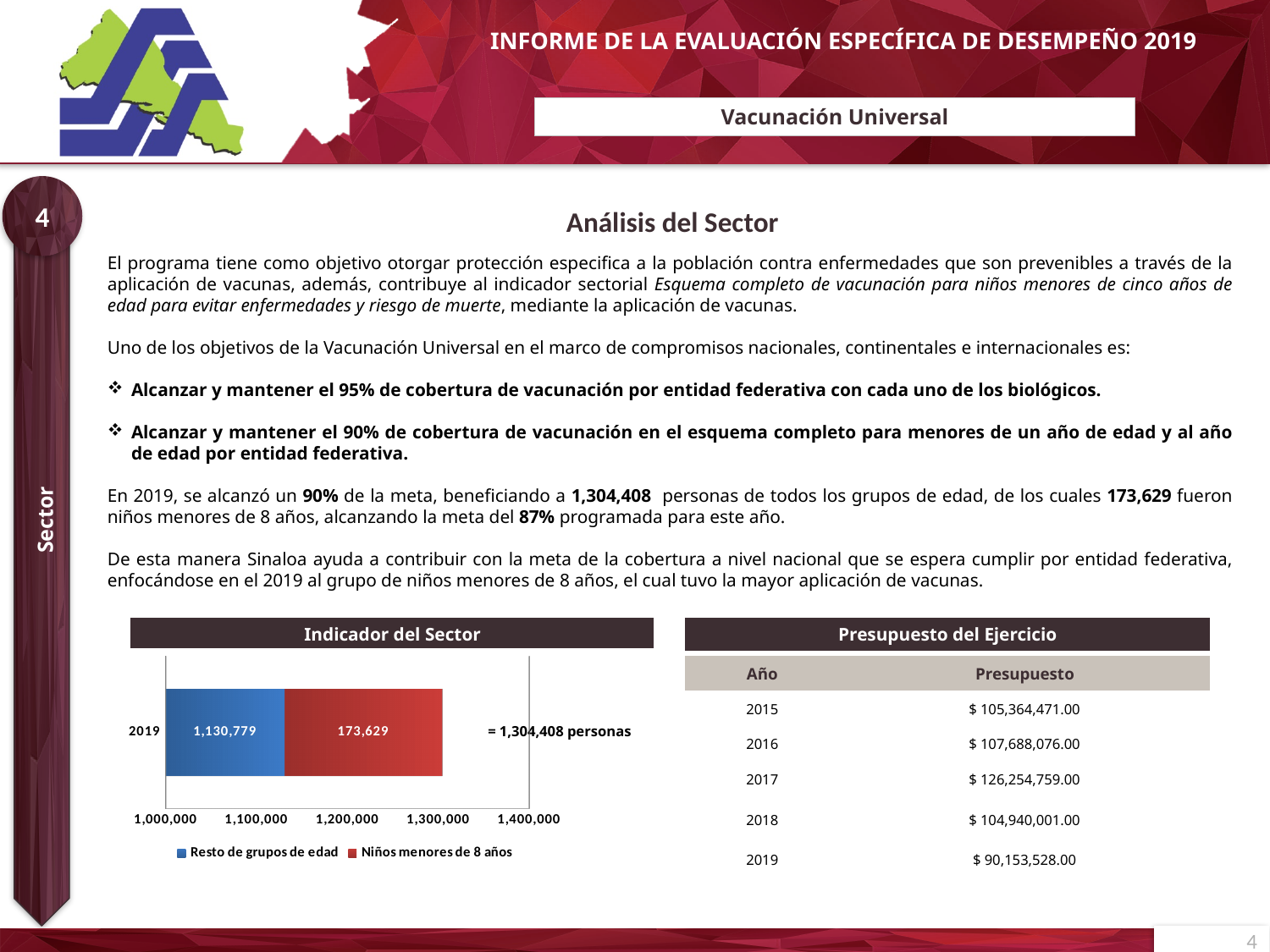
In the 'Indicador del Sector' chart, what is the value for 'Niños menores de 8 años' in 2019? 173,629 In the 'Indicador del Sector' chart, which series has the larger value: 'Resto de grupos de edad' or 'Niños menores de 8 años'? Resto de grupos de edad How many categories (years) are plotted in the 'Indicador del Sector' chart? 1 In the 'Indicador del Sector' chart, what colour represents 'Resto de grupos de edad'? Blue In the 'Indicador del Sector' chart, which series has the smallest value? Niños menores de 8 años In the 'Indicador del Sector' chart, what colour represents 'Niños menores de 8 años'? Red What kind of chart is the 'Indicador del Sector' chart? Stacked bar chart How many series does the legend of the 'Indicador del Sector' chart list? 2 In the 'Indicador del Sector' chart, what is the difference between the 'Resto de grupos de edad' value and the 'Niños menores de 8 años' value? 957,150 In the 'Indicador del Sector' chart, what is the value for 'Resto de grupos de edad' in 2019? 1,130,779 In the 'Indicador del Sector' chart, is the value for 'Resto de grupos de edad' greater or less than 1,100,000? greater In the 'Indicador del Sector' chart, what is the total of the stacked bar for 2019? 1,304,408 personas